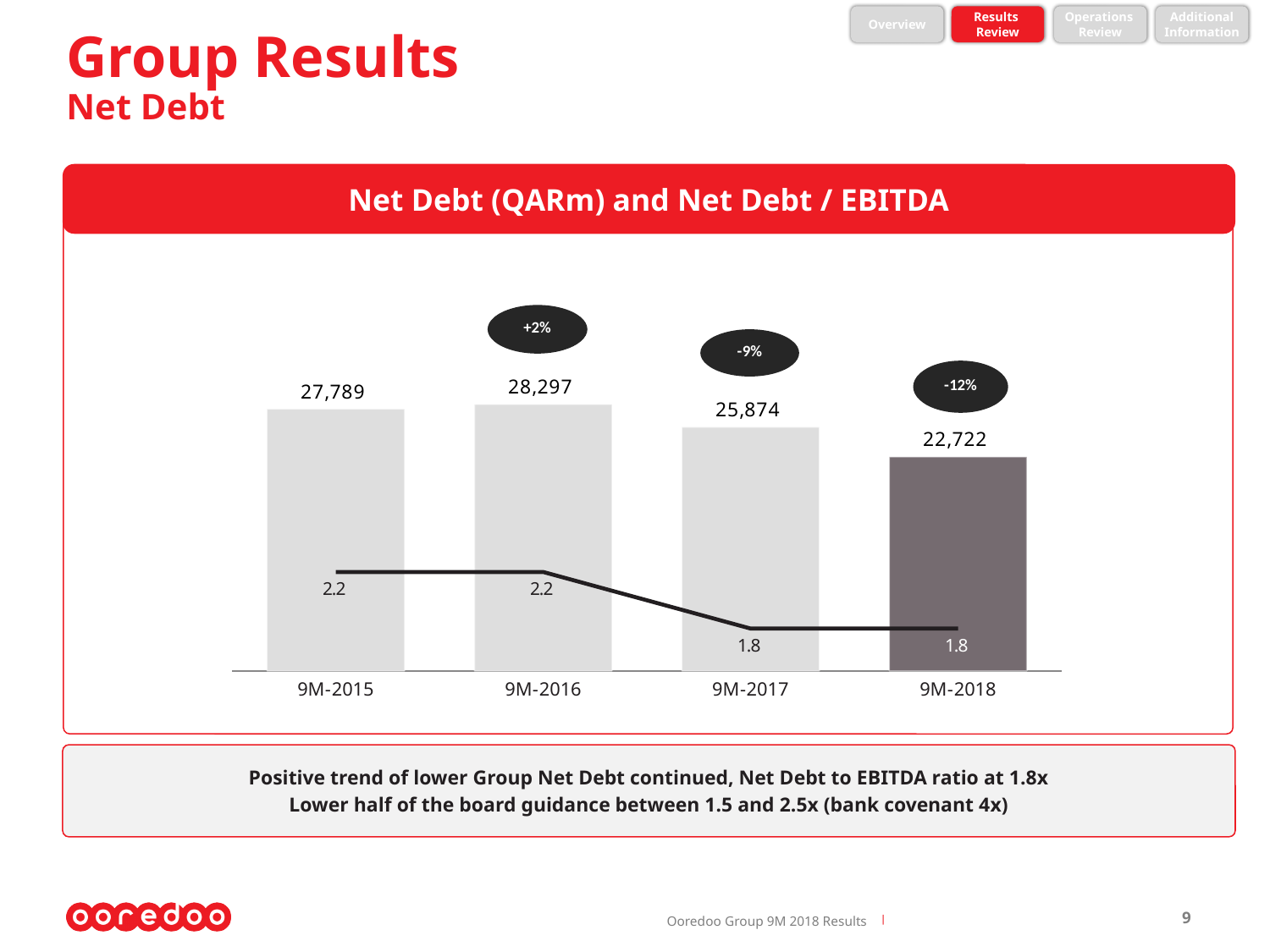
What is the Net Debt / EBITDA ratio for 9M-2017? 1.8 What is the Net Debt (QARm) for 9M-2015? 27,789 What kind of chart is used to show Net Debt (QARm)? Bar chart How many periods are shown on the x axis of the chart? 4 Which period has the highest Net Debt (QARm)? 9M-2016 What is the difference in Net Debt (QARm) between 9M-2017 and 9M-2018? 3,152 Does the Net Debt (QARm) rise or fall from 9M-2016 to 9M-2018? Fall Which is larger, the Net Debt for 9M-2015 or for 9M-2016? 9M-2016 What is the title of the chart? Net Debt (QARm) and Net Debt / EBITDA What is the Net Debt (QARm) for 9M-2018? 22,722 Which period has the lowest Net Debt (QARm)? 9M-2018 What percentage change is shown above the 9M-2018 bar? -12%